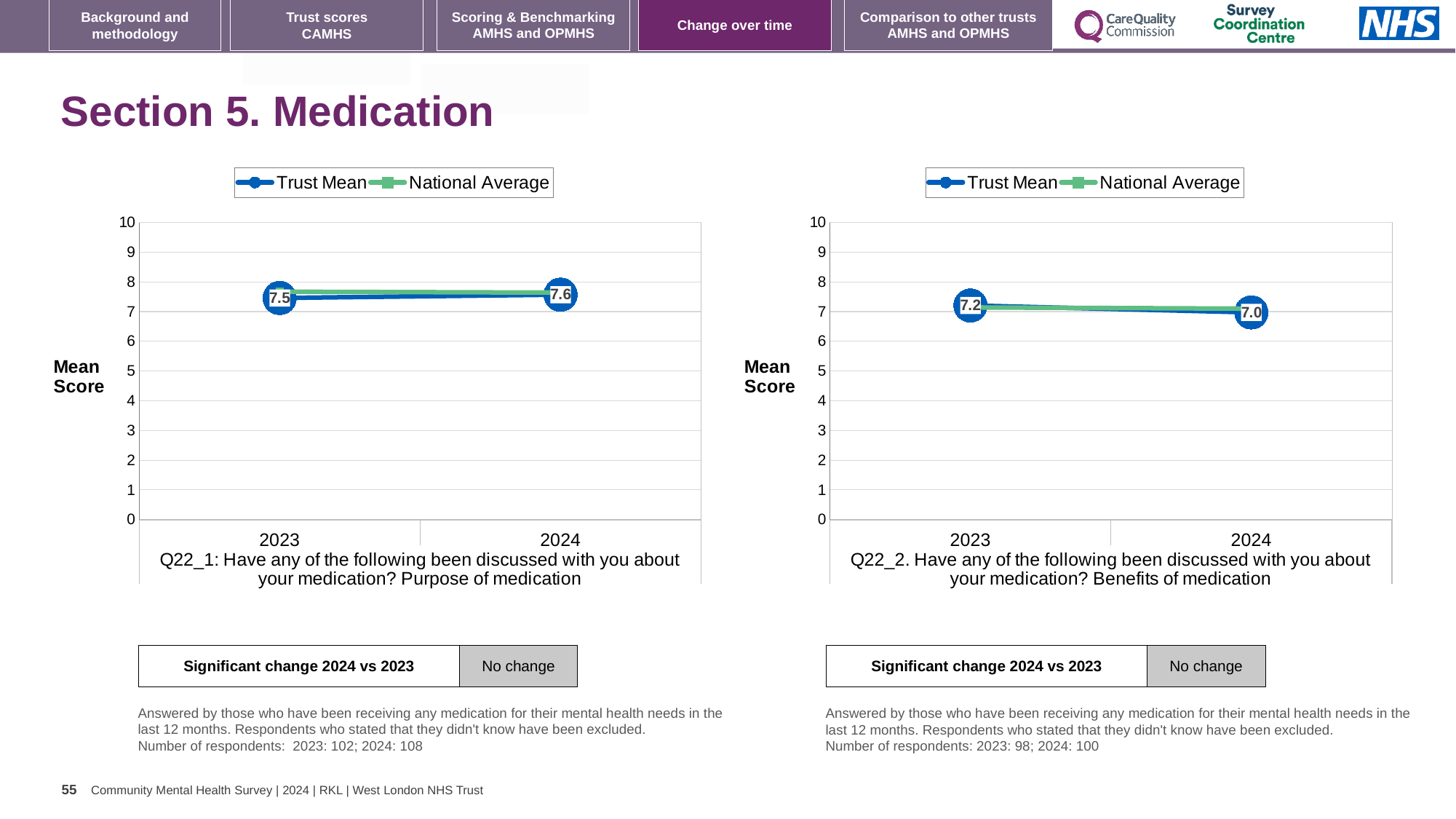
What kind of chart is the left chart (Q22_1: Purpose of medication)? line chart On the right chart (Q22_2: Benefits of medication), what is the difference between the Trust Mean in 2023 and 2024? 0.2 On the left chart (Q22_1: Purpose of medication), what is the Trust Mean score for 2024? 7.6 How many series does the legend of the right chart (Q22_2: Benefits of medication) list? 2 On the left chart (Q22_1: Purpose of medication), by how much did the Trust Mean change from 2023 to 2024? 0.1 On the right chart (Q22_2: Benefits of medication), what is the Trust Mean score for 2024? 7.0 On the left chart (Q22_1: Purpose of medication), does the Trust Mean rise or fall from 2023 to 2024? rise On the right chart (Q22_2: Benefits of medication), what is the Trust Mean score for 2023? 7.2 How many years are plotted on the x axis of the left chart (Q22_1: Purpose of medication)? 2 On the left chart (Q22_1: Purpose of medication), what is the Trust Mean score for 2023? 7.5 On the right chart (Q22_2: Benefits of medication), is the National Average value for 2024 greater or less than 5? greater On the right chart (Q22_2: Benefits of medication), does the Trust Mean rise or fall from 2023 to 2024? fall